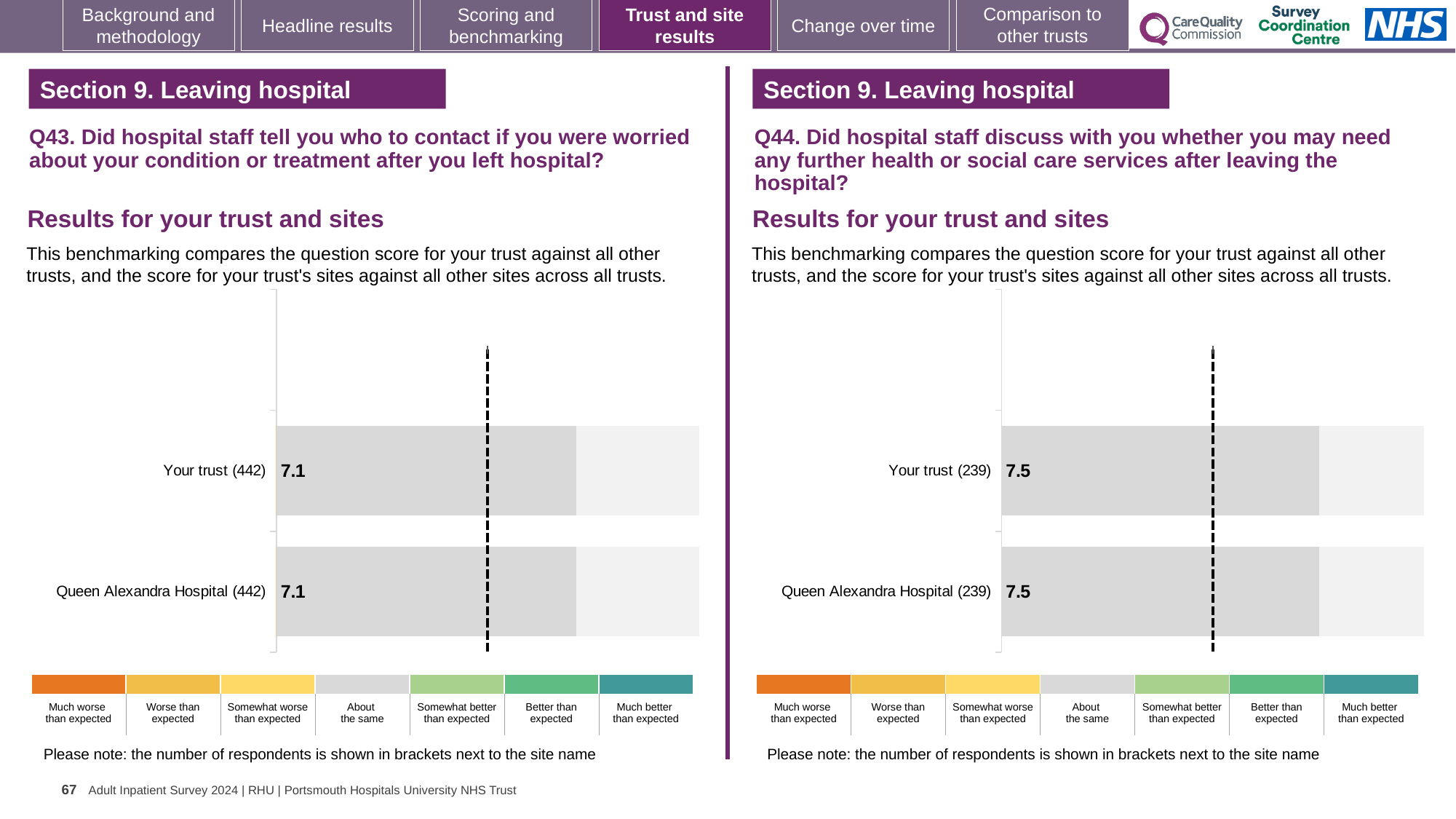
What kind of chart is the Q43 chart on the left? Bar chart In the Q43 chart on the left, what is the score for Your trust? 7.1 In the Q44 chart on the right, what is the score for Your trust? 7.5 In the Q43 chart on the left, what is the difference between the score for Your trust and the score for Queen Alexandra Hospital? 0.0 In the Q43 chart on the left, how many respondents are shown in brackets for Your trust? 442 In the Q44 chart on the right, how many bars are plotted? 2 In the Q44 chart on the right, how many respondents are shown in brackets for Queen Alexandra Hospital? 239 In the Q44 chart on the right, what is the score for Queen Alexandra Hospital? 7.5 In the Q43 chart on the left, which category is listed first (at the top)? Your trust (442) In the Q43 chart on the left, what is the score for Queen Alexandra Hospital? 7.1 How many categories does the colour key below the Q44 chart on the right list? 7 Is the score for Your trust in the Q43 chart on the left larger than, smaller than, or equal to the score for Your trust in the Q44 chart on the right? Smaller